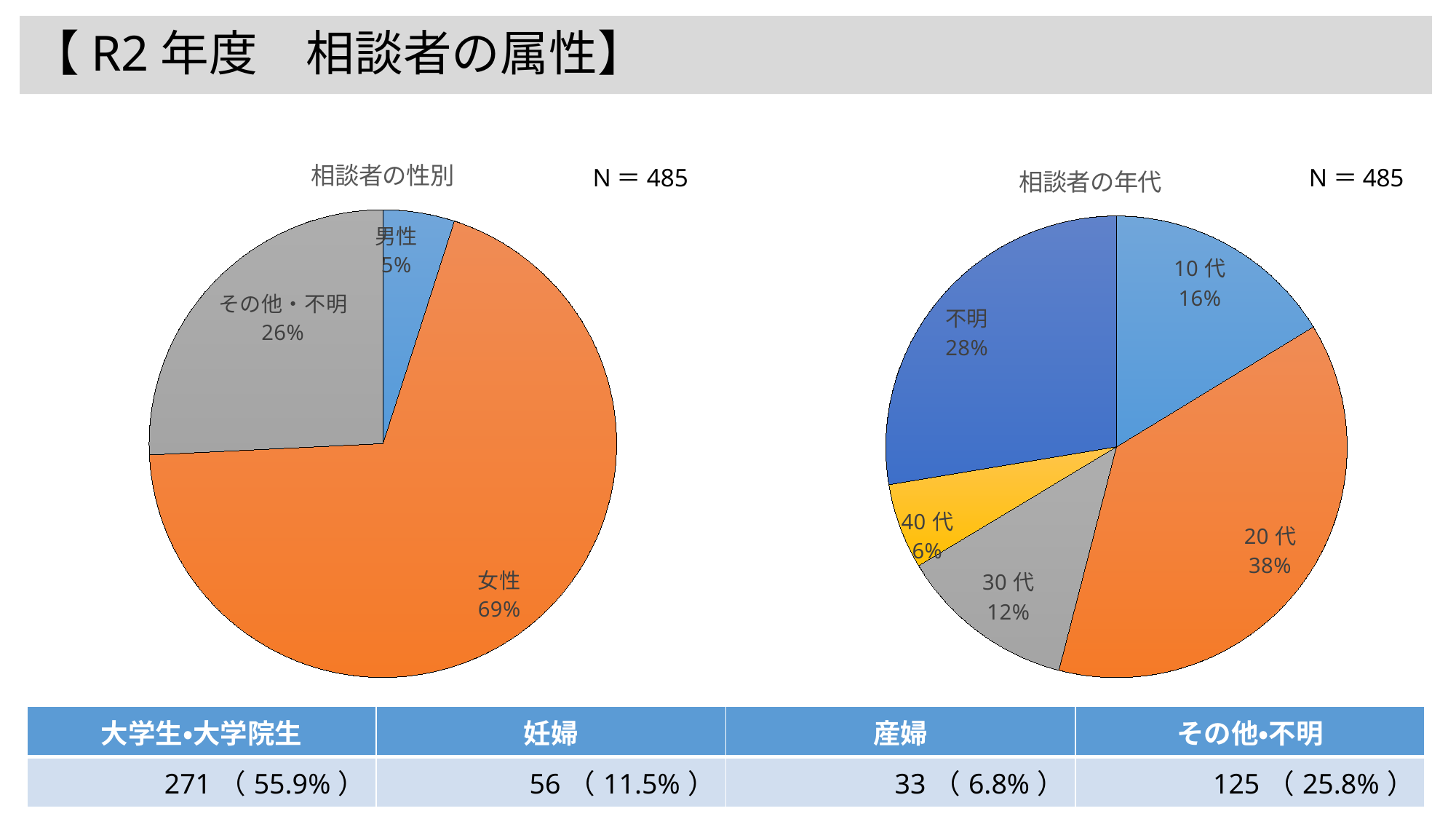
In the 相談者の年代 chart, what percentage is 20代? 38% In the 相談者の性別 chart, which category has the largest share? 女性 In the 相談者の年代 chart, what is the difference in percentage points between 20代 and 10代? 22 In the 相談者の性別 chart, what percentage is その他・不明? 26% What type of chart is the 相談者の年代 chart? Pie chart In the 相談者の年代 chart, which age group has the smallest share? 40代 In the 相談者の年代 chart, which is larger, 30代 or 不明? 不明 In the 相談者の性別 chart, what percentage is 男性? 5% In the 相談者の年代 chart, what percentage is 不明? 28% In the 相談者の性別 chart, how many slices does the pie have? 3 In the 相談者の性別 chart, what percentage is 女性? 69% In the 相談者の年代 chart, how many slices does the pie have? 5